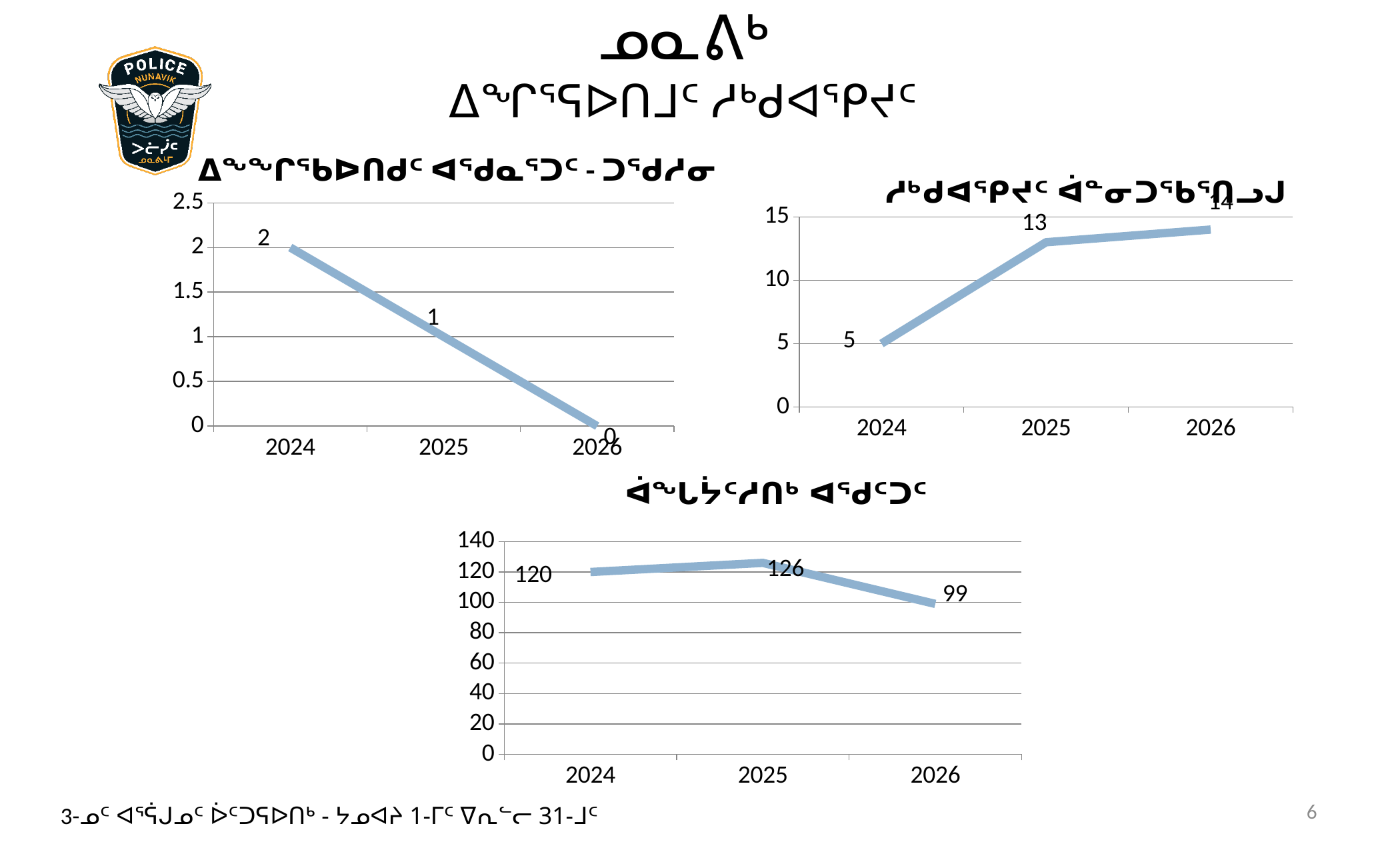
In the bottom chart, which is larger, the value for 2024 or the value for 2026? 2024 In the bottom chart, what is the value for 2026? 99 In the bottom chart, which year has the highest value? 2025 In the bottom chart, what is the difference between the 2025 and 2026 values? 27 In the top-right chart, which year has the lowest value? 2024 In the top-right chart, what is the value for 2025? 13 In the top-left chart, what is the value for 2024? 2 What kind of chart is the bottom chart? line chart In the top-left chart, what is the value for 2026? 0 In the top-right chart, do the values rise or fall from 2024 to 2026? rise In the top-right chart, what is the difference between the 2025 and 2024 values? 8 In the top-left chart, do the values rise or fall from 2024 to 2026? fall